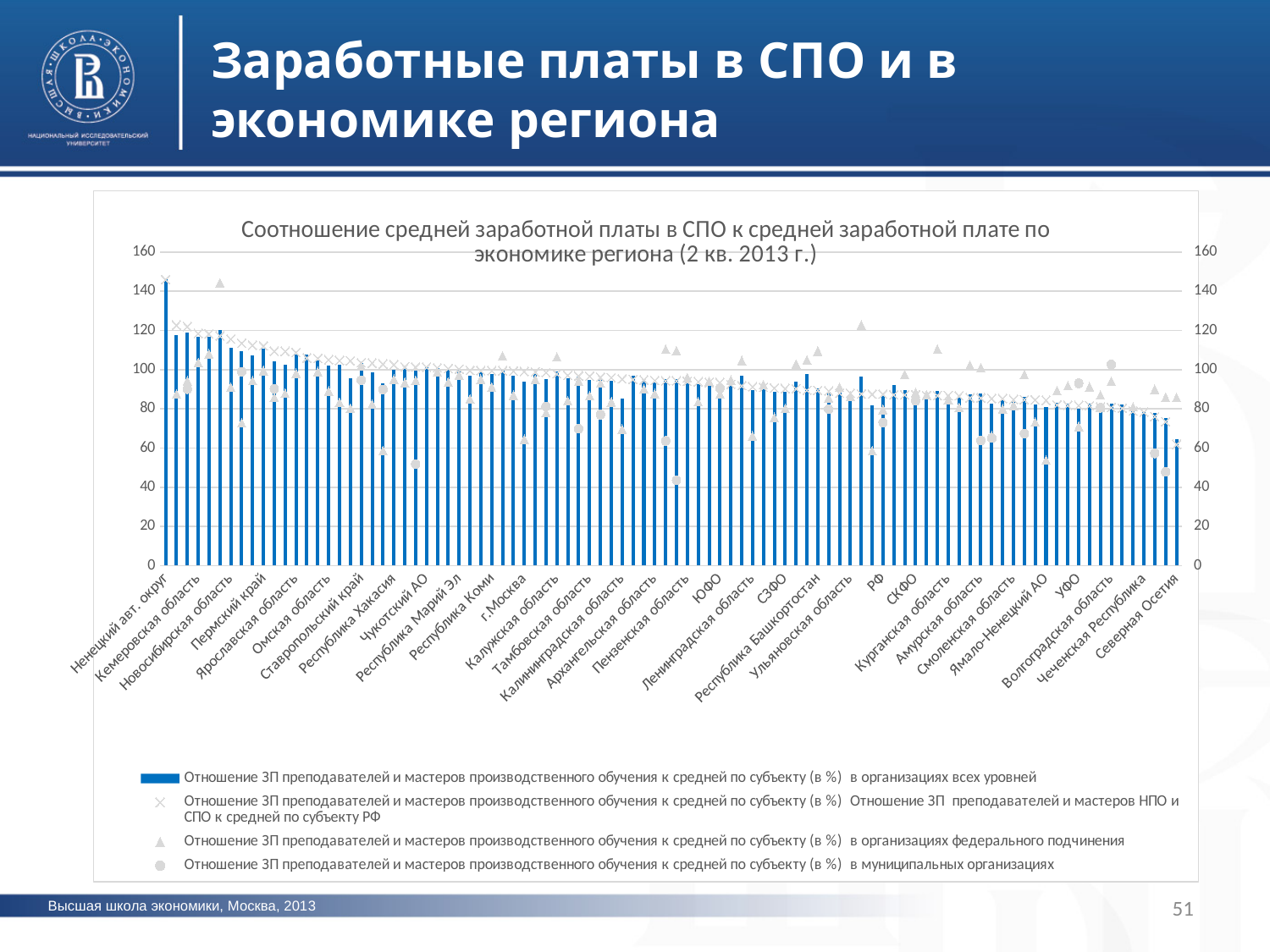
Which quarter and year does the chart title refer to? 2 кв. 2013 г. Is the bar value for Северная Осетия greater or less than 80? less Which region has the highest bar value? Ненецкий авт. округ What kind of chart is used for the series 'в организациях всех уровней'? bar chart Which region has the lowest bar value? Северная Осетия Is the bar value for Кемеровская область greater or less than 100? greater What is the maximum value shown on the vertical axis? 160 Is the bar value for Ненецкий авт. округ greater or less than 120? greater Do the bar values generally rise or fall from left to right along the x axis? fall How many series does the legend list? 4 Which has the larger bar value, Ненецкий авт. округ or Северная Осетия? Ненецкий авт. округ